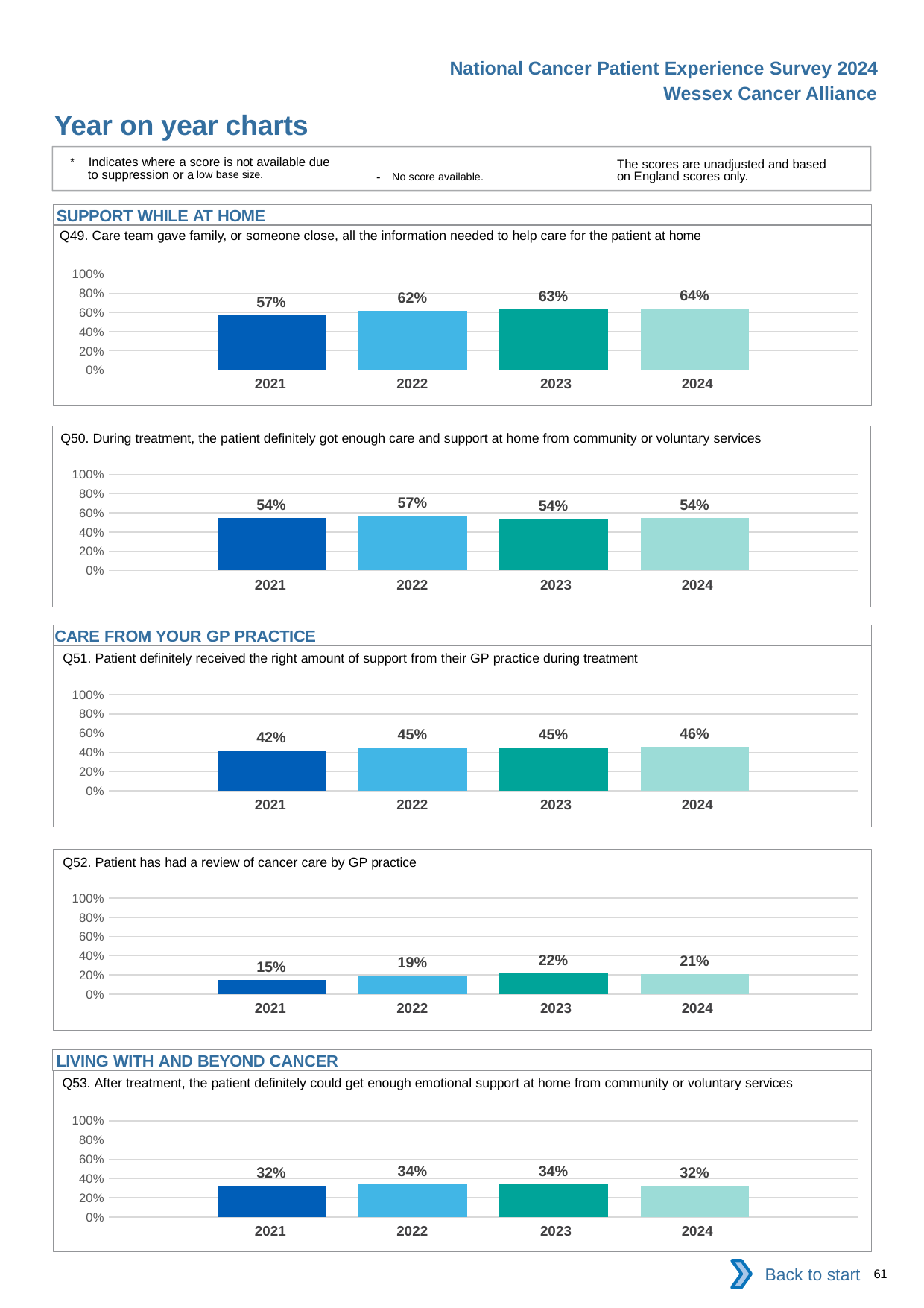
In the Q49 chart, what is the value for 2024? 64% In the Q53 chart, how many years are plotted? 4 In the Q50 chart, which year has the highest value? 2022 In the Q51 chart, is the value for 2024 greater or less than 40%? greater In the Q50 chart, what is the difference between the 2022 and 2021 values? 3% In the Q49 chart, which year has the lowest value? 2021 In the Q49 chart, do the values rise or fall from 2021 to 2024? Rise In the Q51 chart, what is the value for 2021? 42% In the Q52 chart, which year has the highest value? 2023 What kind of chart is the Q49 chart? Bar chart In the Q53 chart, which is larger, the value for 2022 or the value for 2024? 2022 In the Q52 chart, what is the difference between the 2023 and 2021 values? 7%